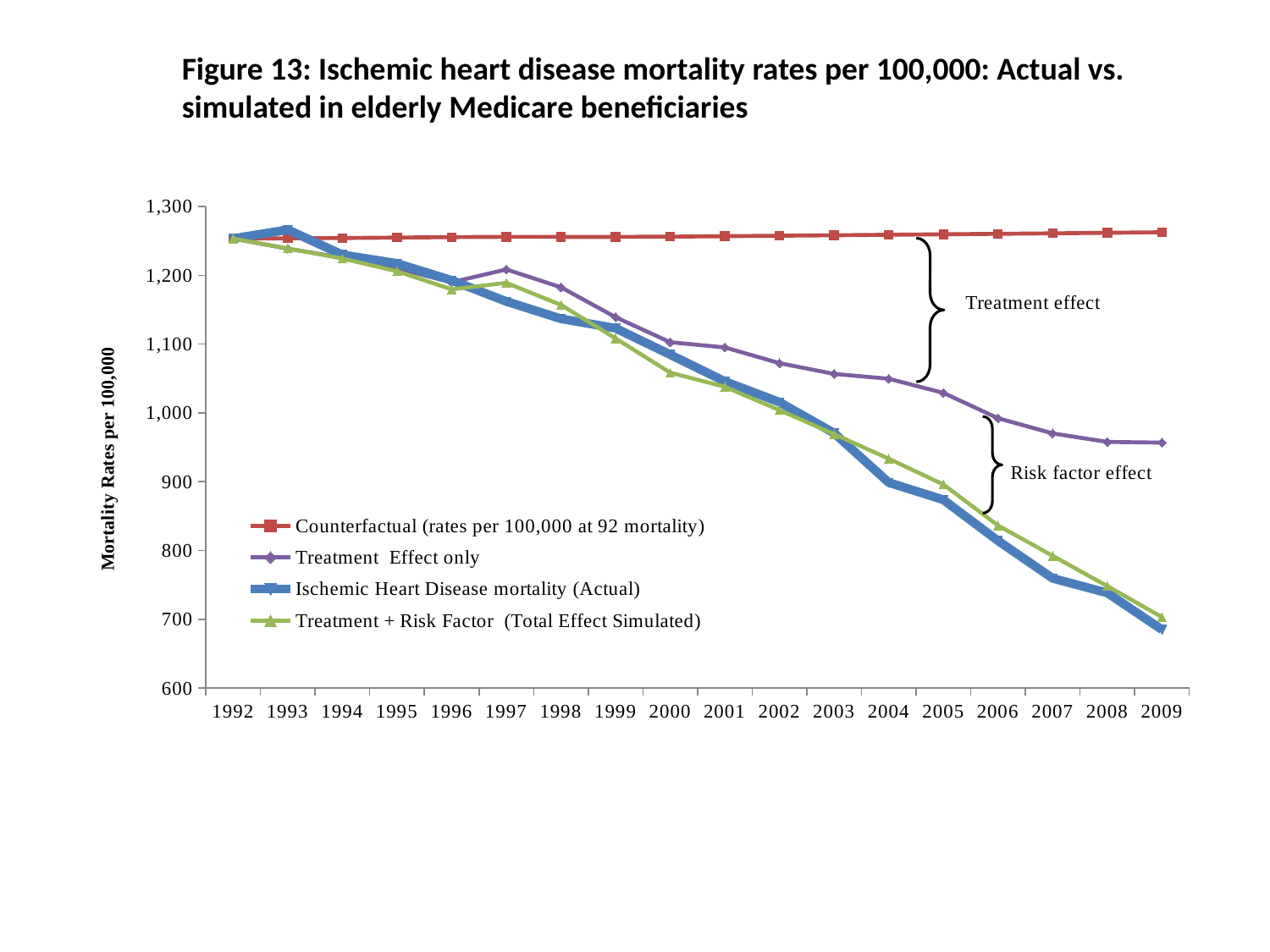
How many years are shown along the x axis? 18 In which year is the Ischemic Heart Disease mortality (Actual) series at its lowest? 2009 What kind of chart is shown on the slide? Line chart In 2007, which is larger: the Treatment Effect only value or the Treatment + Risk Factor (Total Effect Simulated) value? Treatment Effect only Is the value for Treatment Effect only in 2009 greater or less than 1,000? less Is the value for Ischemic Heart Disease mortality (Actual) in 2009 greater or less than 700? less Which series has the highest value in 2009? Counterfactual (rates per 100,000 at 92 mortality) Is the value for Counterfactual in 2009 greater or less than 1,200? greater How many series does the legend list? 4 What label is attached to the bracket between the Counterfactual line and the Treatment Effect only line? Treatment effect Does the Counterfactual series rise or fall from 1992 to 2009? Rise Does the Ischemic Heart Disease mortality (Actual) series rise or fall from 1992 to 2009? Fall